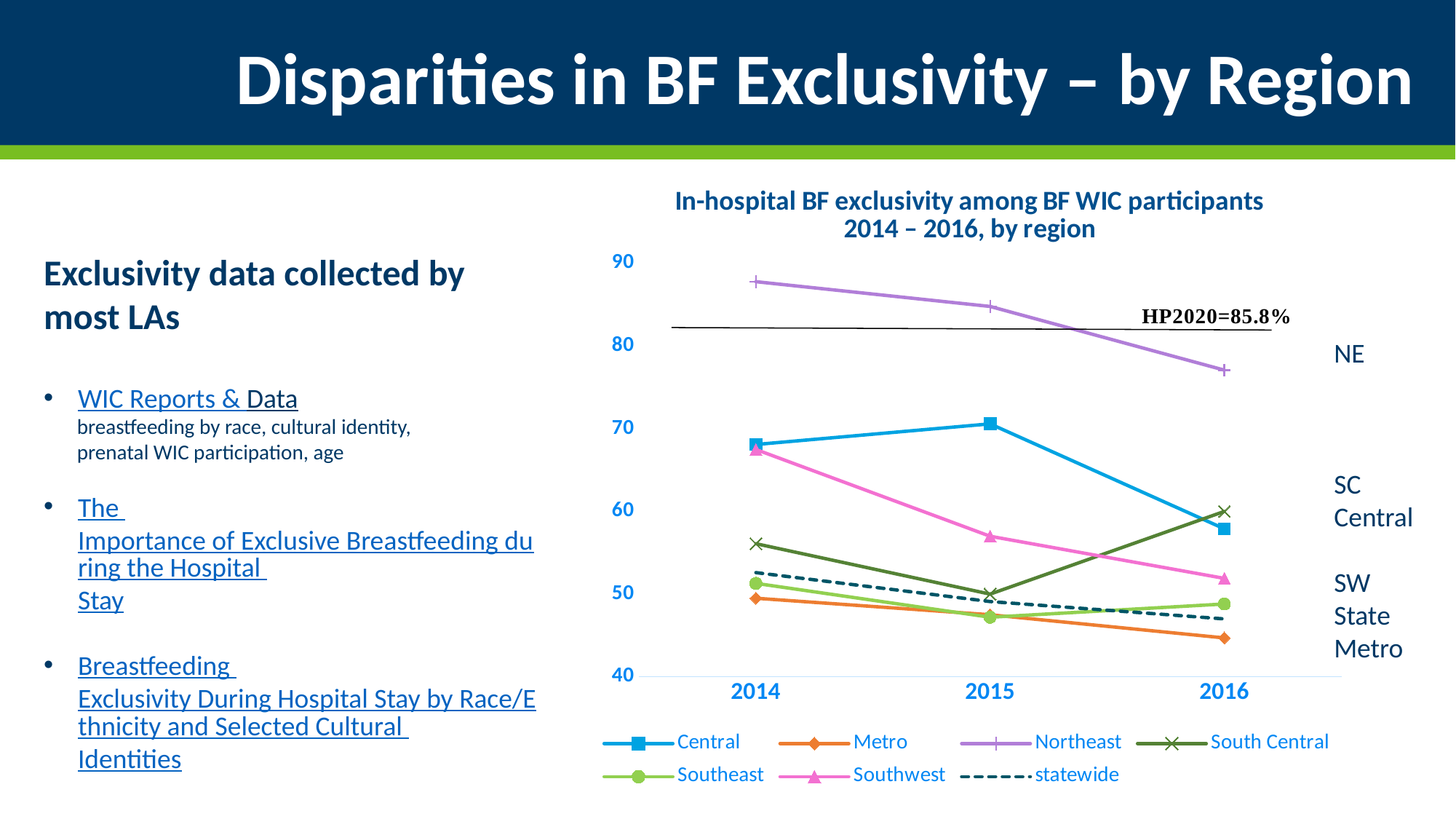
What kind of chart is shown on the slide? line chart Which region has the lowest in-hospital BF exclusivity in 2016? Metro How many years are plotted along the x axis? 3 Is the value for Metro in 2016 greater or less than 50? less Is the value for Northeast in 2016 greater or less than 80? less What target value is marked by the horizontal reference line labelled HP2020? 85.8% Which region has the highest in-hospital BF exclusivity in 2014? Northeast Does the Northeast line rise or fall from 2014 to 2016? fall In 2015, which is larger: the value for Central or the value for Southwest? Central How many series does the chart legend list? 7 Is the value for Northeast in 2014 greater or less than 80? greater